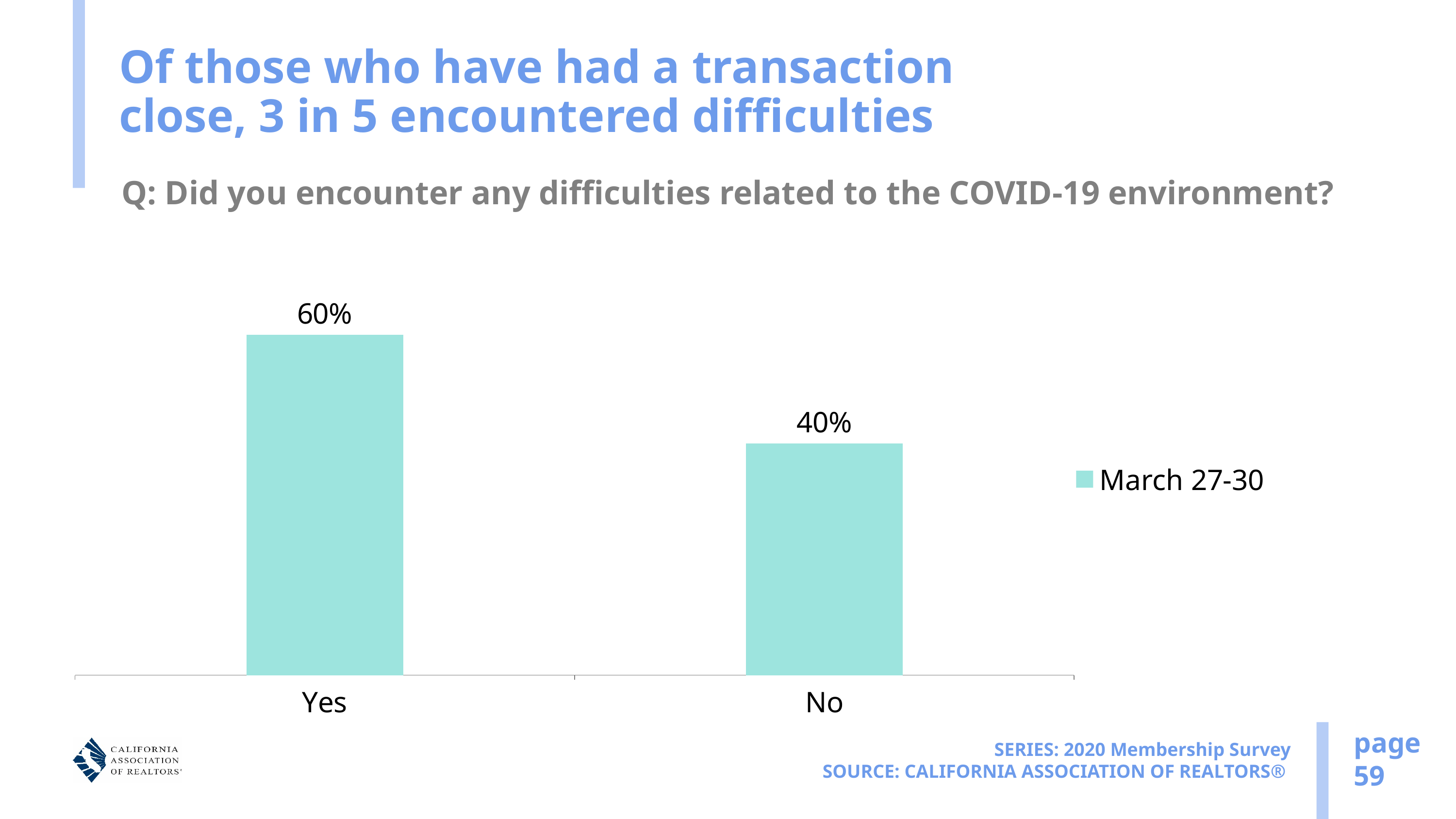
What series name is shown in the chart legend? March 27-30 What kind of chart is shown on the slide? Bar chart Which is larger, the value for Yes or the value for No? Yes How many series does the legend list? 1 What percentage of respondents answered Yes? 60% What is the total of the Yes and No percentages? 100% What percentage of respondents answered No? 40% Do the values rise or fall from Yes to No along the x axis? Fall What is the difference between the Yes and No percentages? 20% How many response categories are shown on the chart? 2 Which response category has the lowest value? No Which response category has the highest value? Yes